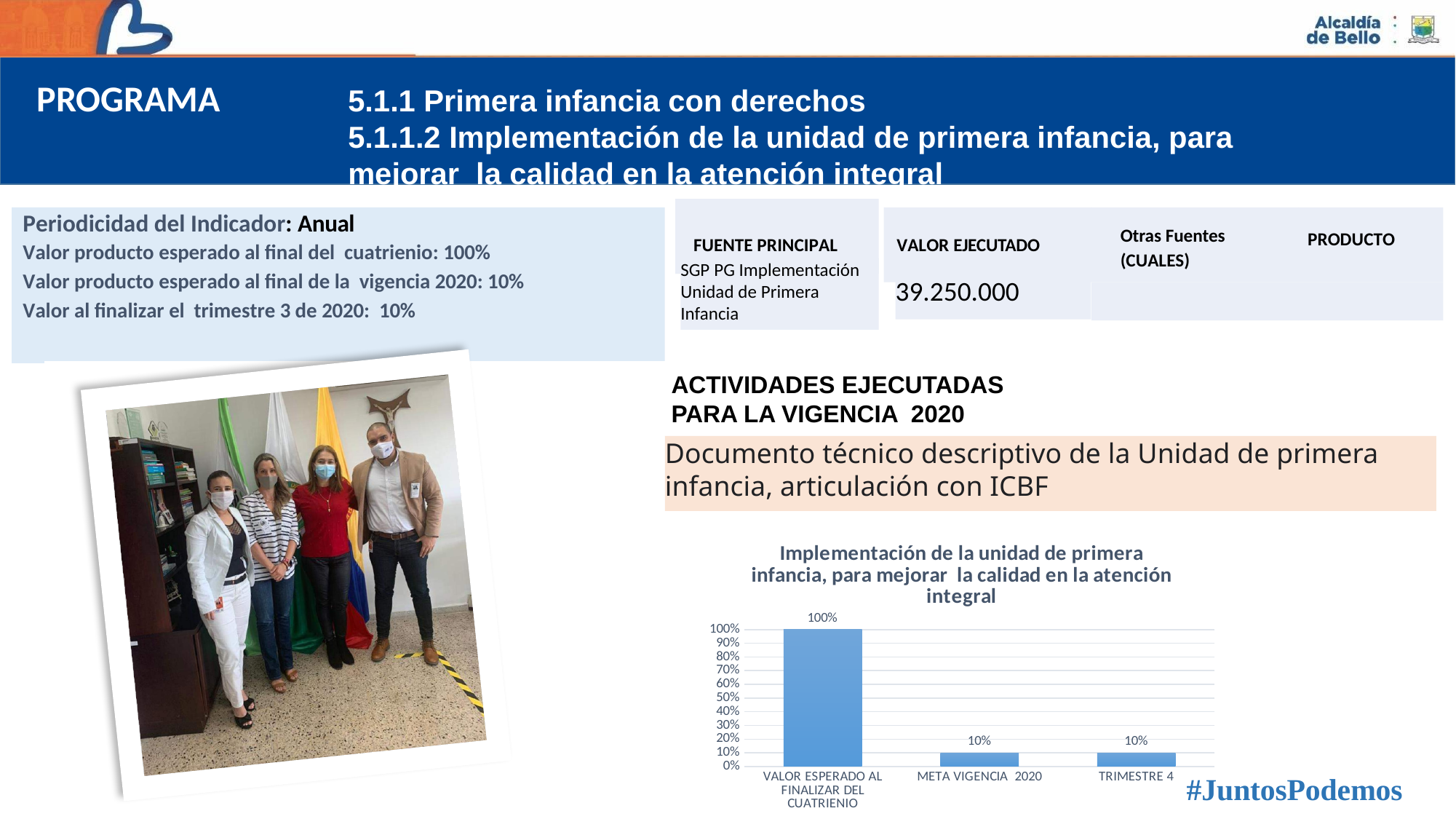
How many categories are shown on the chart? 3 What is the highest value shown on the chart's vertical axis? 100% What is the value for TRIMESTRE 4? 10% What kind of chart is shown on the slide? bar chart Which category has the highest value? VALOR ESPERADO AL FINALIZAR DEL CUATRIENIO Do the values for META VIGENCIA 2020 and TRIMESTRE 4 differ? No, both are 10% What is the title of the chart? Implementación de la unidad de primera infancia, para mejorar la calidad en la atención integral Which is larger, the value for VALOR ESPERADO AL FINALIZAR DEL CUATRIENIO or the value for TRIMESTRE 4? VALOR ESPERADO AL FINALIZAR DEL CUATRIENIO What is the difference between the value for VALOR ESPERADO AL FINALIZAR DEL CUATRIENIO and the value for META VIGENCIA 2020? 90% What is the value for VALOR ESPERADO AL FINALIZAR DEL CUATRIENIO? 100% Is the value for META VIGENCIA 2020 greater or less than 50%? less What is the value for META VIGENCIA 2020? 10%